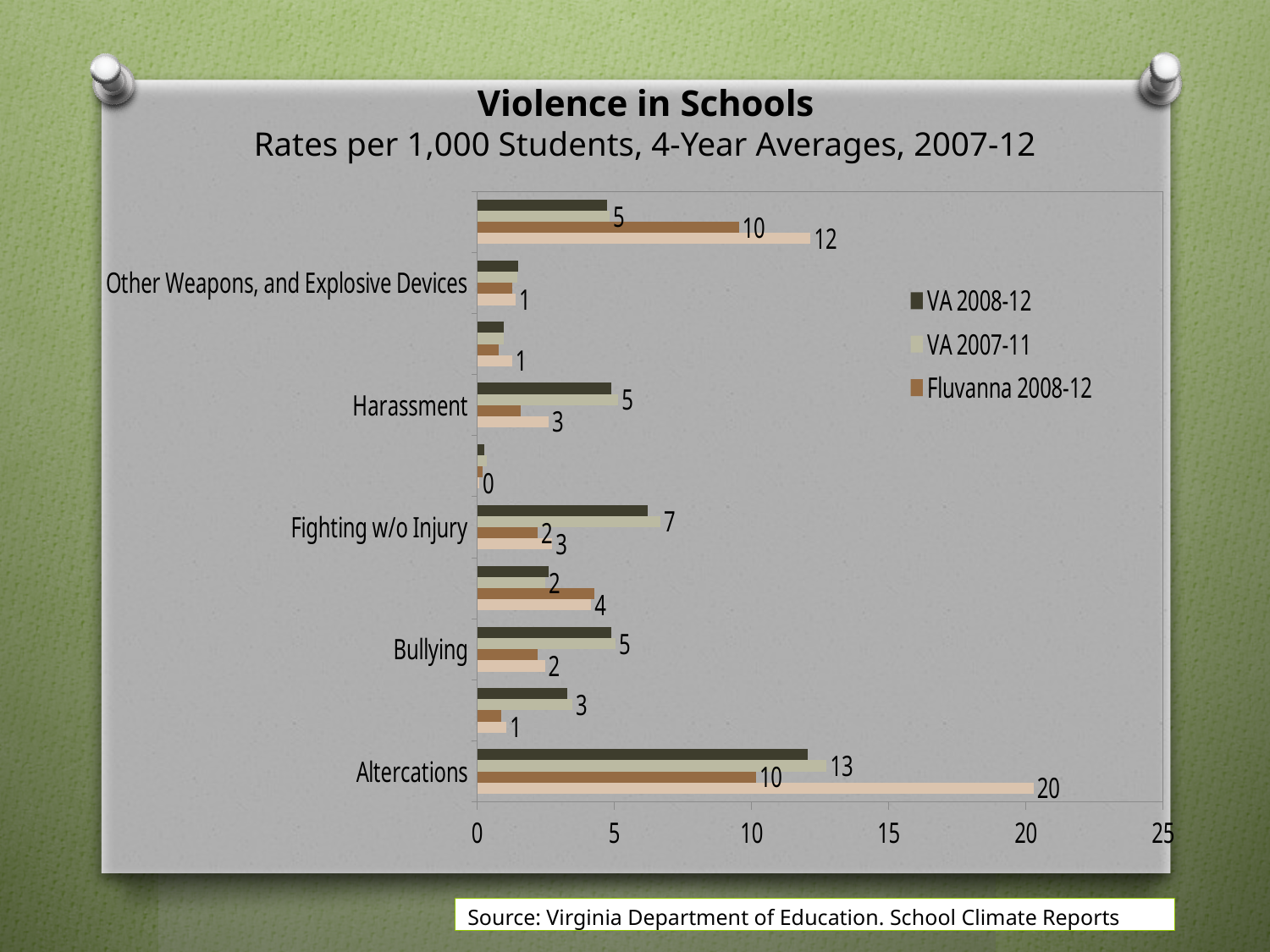
For Fighting w/o Injury, which is larger: the VA 2007-11 value or the Fluvanna 2008-12 value? VA 2007-11 What is the Fluvanna 2008-12 value for Altercations? 10 What is the difference between the VA 2007-11 and Fluvanna 2008-12 values for Altercations? 3 What is the VA 2007-11 value for Harassment? 5 What kind of chart is shown on the slide? bar chart Which labeled category has the highest VA 2007-11 value? Altercations What is the Fluvanna 2008-12 value for Fighting w/o Injury? 2 What is the VA 2007-11 value for Fighting w/o Injury? 7 Is the VA 2008-12 value for Altercations greater or less than 10? greater How many series does the legend list? 3 What is the VA 2007-11 value for Altercations? 13 What is the title of the chart? Violence in Schools